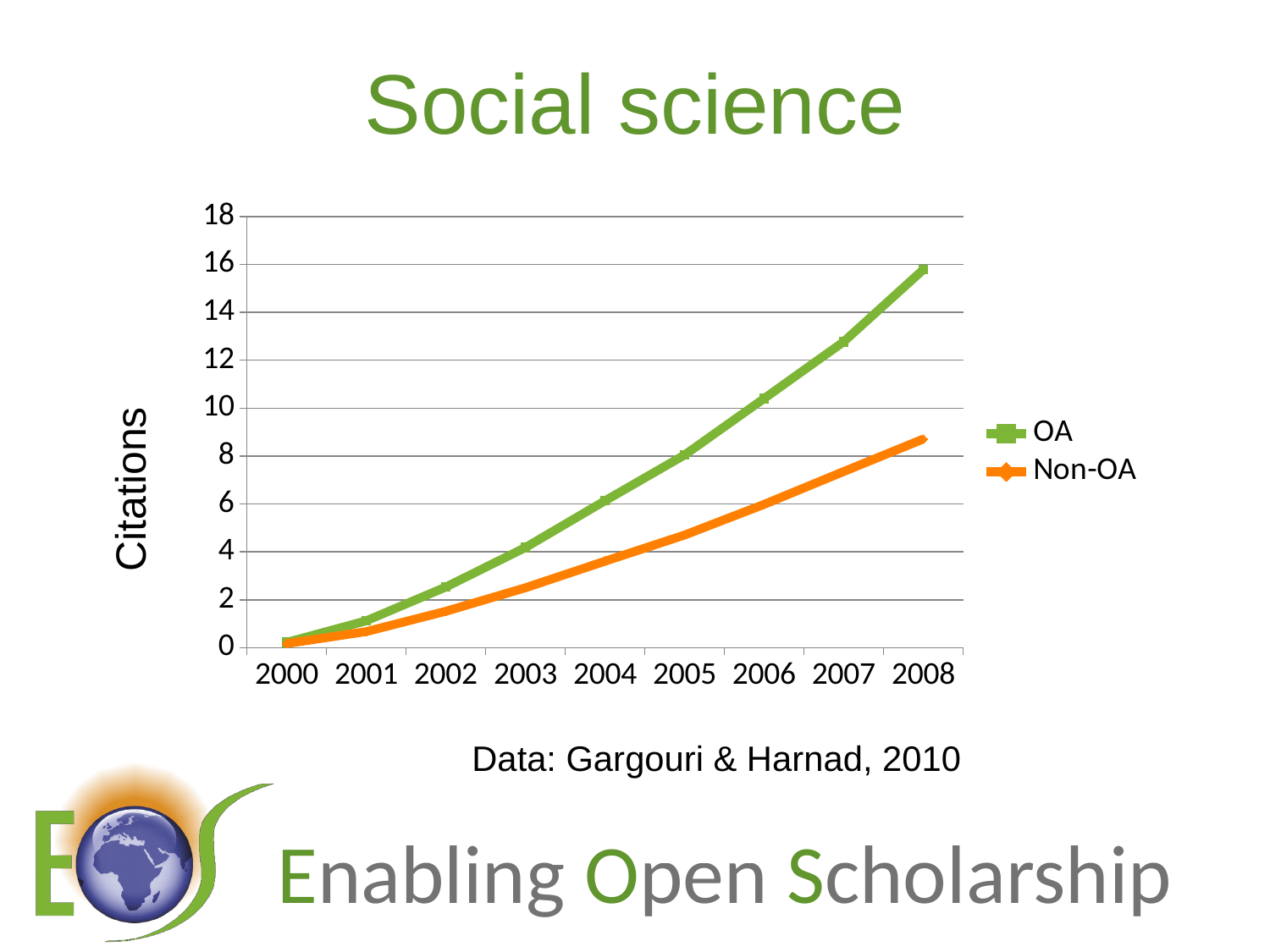
How many years are shown on the x axis? 9 What is the label on the y axis? Citations Is the value for OA in 2008 greater or less than 14? greater Is the value for Non-OA in 2005 greater or less than 6? less Is the value for Non-OA in 2008 greater or less than 10? less How many series does the legend list? 2 Do the OA citations rise or fall from 2000 to 2008? rise In which year is the Non-OA series at its lowest value? 2000 In which year does the OA series reach its highest value? 2008 Which series has the higher value in 2008, OA or Non-OA? OA What type of chart is shown on the slide? line chart